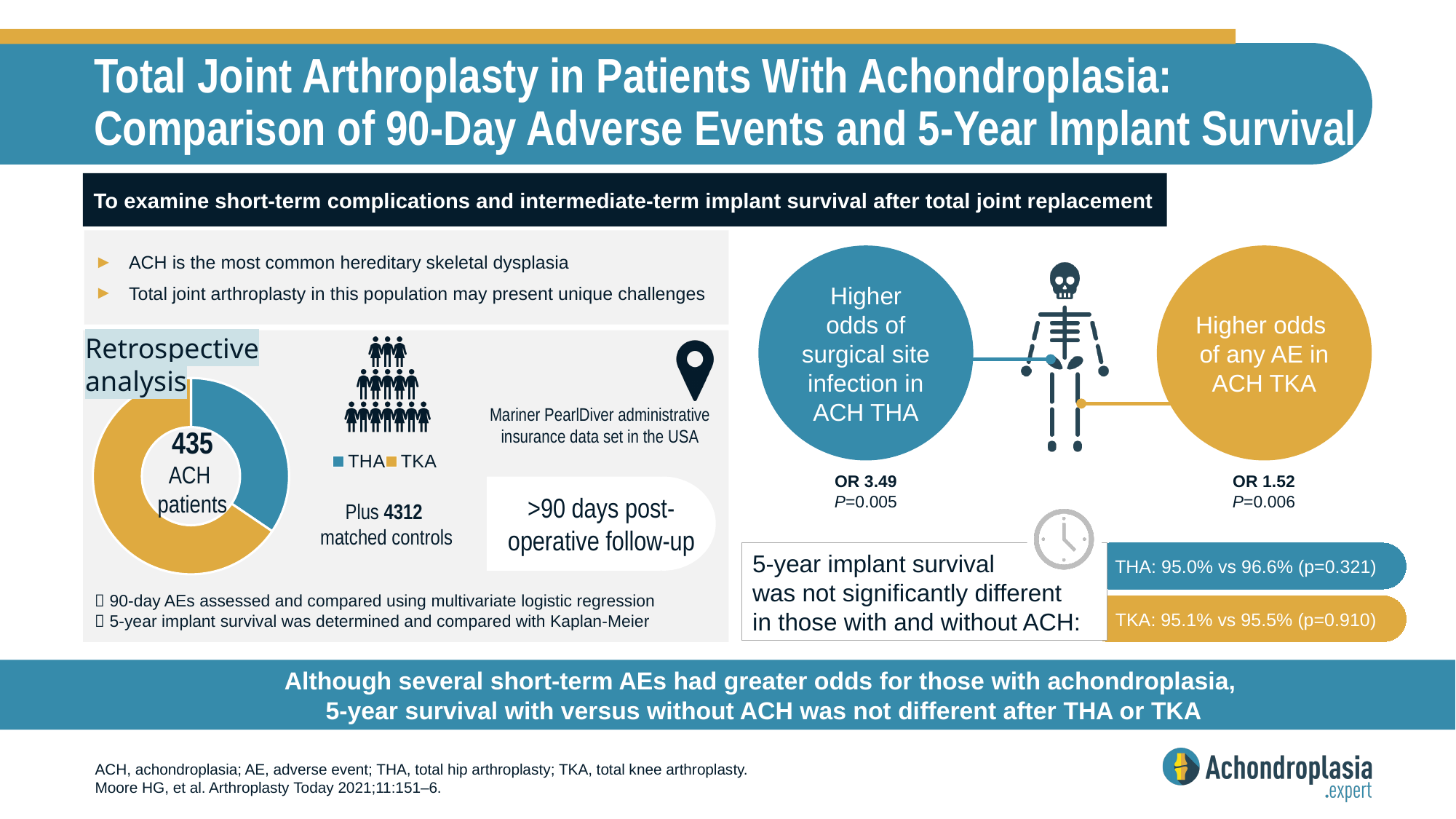
Which category has the smaller slice in the donut chart? THA What number is printed in the centre of the donut chart? 435 Which category has the larger slice in the donut chart, THA or TKA? TKA What kind of chart is shown in the Retrospective analysis section? Donut (pie) chart How many slices does the donut chart have? 2 How many categories does the donut chart's legend list? 2 What colour represents TKA in the donut chart? Gold/yellow Which category has the largest slice in the donut chart? TKA